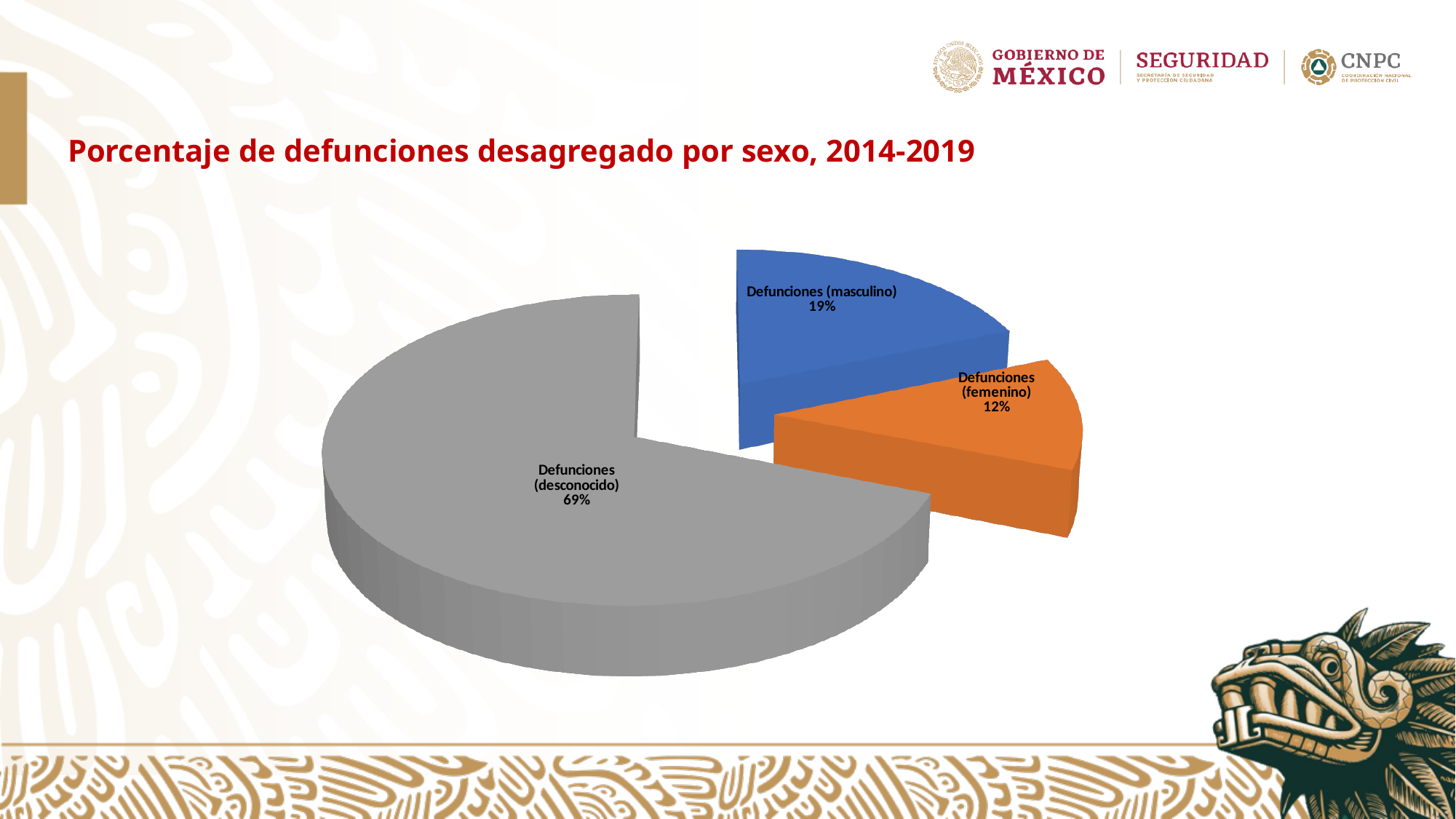
What kind of chart is shown on the slide? Pie chart What is the difference in percentage points between Defunciones (masculino) and Defunciones (femenino)? 7 Which is larger, the share for Defunciones (masculino) or Defunciones (femenino)? Defunciones (masculino) What percentage is shown for Defunciones (desconocido)? 69% Which category has the smallest share of the pie? Defunciones (femenino) How many slices does the pie chart have? 3 What percentage is shown for Defunciones (masculino)? 19% What percentage is shown for Defunciones (femenino)? 12% What is the difference in percentage points between Defunciones (desconocido) and Defunciones (masculino)? 50 What is the title of the chart on the slide? Porcentaje de defunciones desagregado por sexo, 2014-2019 Which category has the largest share of the pie? Defunciones (desconocido) What colour is the slice for Defunciones (femenino)? Orange